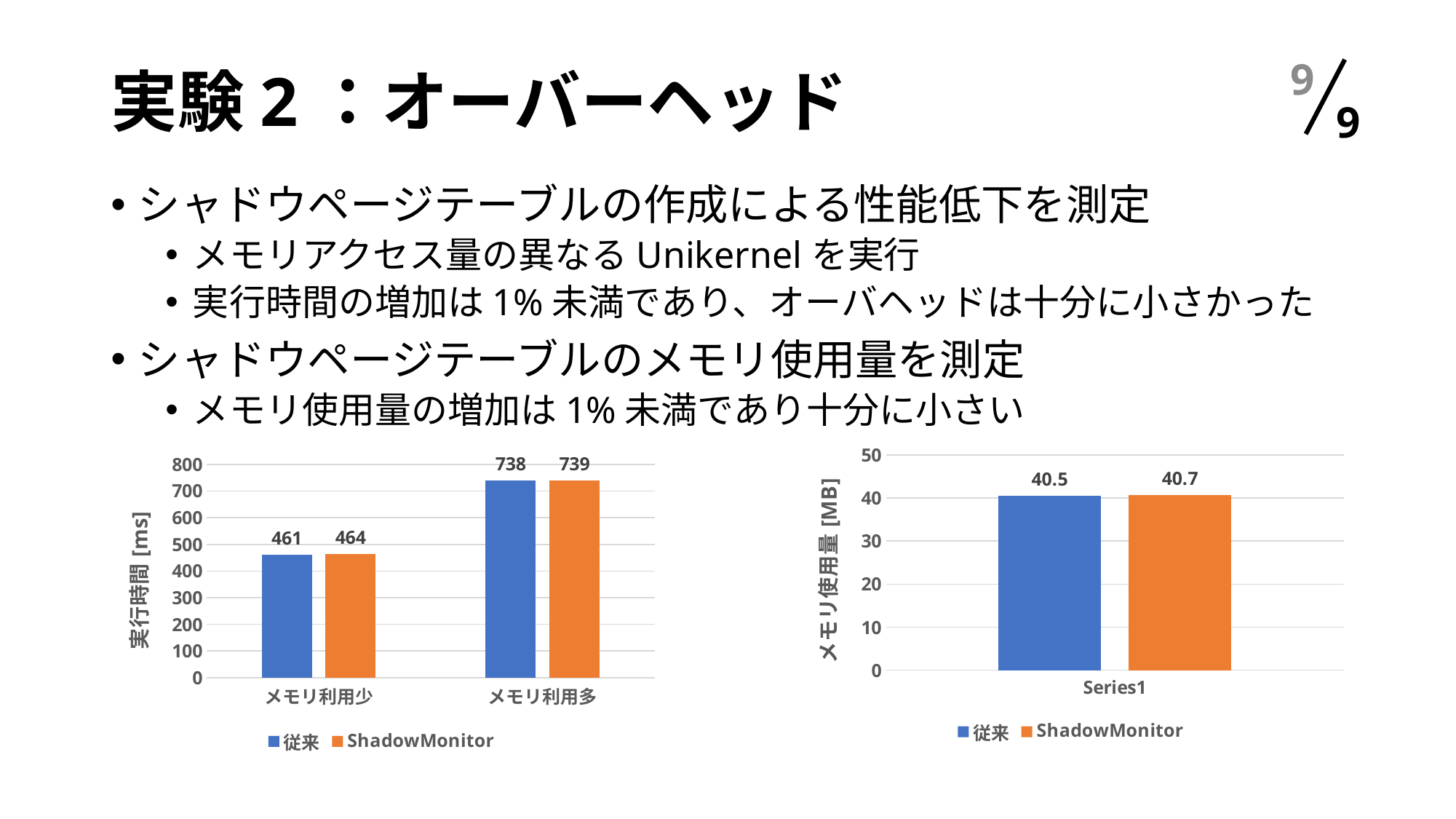
In the left chart (実行時間 [ms]), how many categories are shown on the x axis? 2 In the left chart (実行時間 [ms]), what is the difference between the ShadowMonitor and 従来 values in the メモリ利用少 category? 3 In the left chart (実行時間 [ms]), what is the value for ShadowMonitor in the メモリ利用多 category? 739 In the left chart (実行時間 [ms]), what is the value for 従来 in the メモリ利用少 category? 461 In the left chart (実行時間 [ms]), which category has the higher execution time, メモリ利用少 or メモリ利用多? メモリ利用多 In the left chart (実行時間 [ms]), what is the difference between the 従来 values for メモリ利用多 and メモリ利用少? 277 In the right chart (メモリ使用量 [MB]), what is the difference between the ShadowMonitor and 従来 values? 0.2 In the right chart (メモリ使用量 [MB]), what is the value for 従来? 40.5 In the right chart (メモリ使用量 [MB]), what is the category label shown on the x axis? Series1 In the right chart (メモリ使用量 [MB]), what is the value for ShadowMonitor? 40.7 What kind of chart is the right chart (メモリ使用量 [MB])? Bar chart In the left chart (実行時間 [ms]), how many series does the legend list? 2